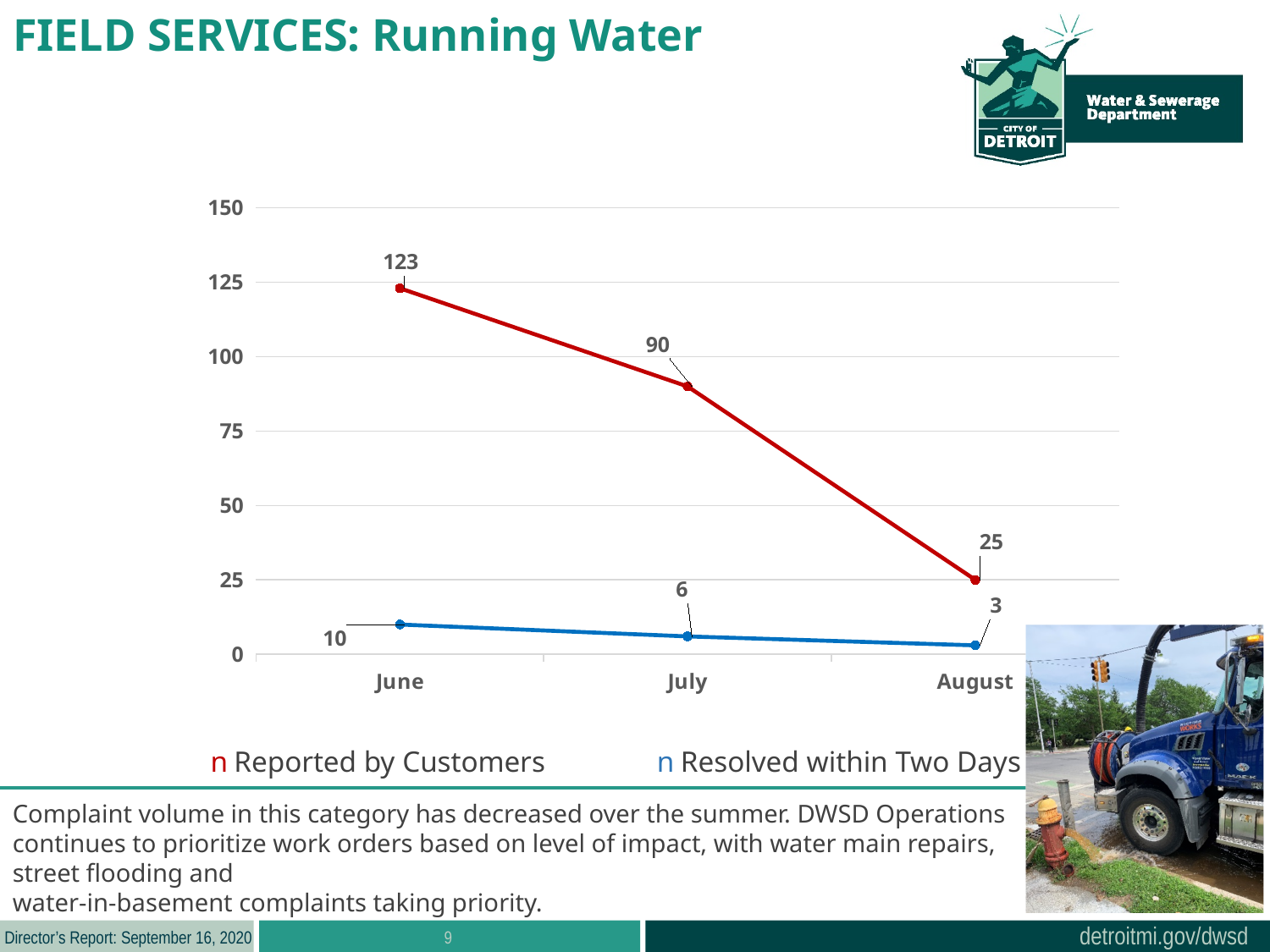
What colour is the line for Resolved within Two Days? blue What is the value for Reported by Customers in July? 90 In which month is Reported by Customers highest? June Does Reported by Customers rise or fall from June to August? fall What is the value for Reported by Customers in June? 123 Which is larger in July: Reported by Customers or Resolved within Two Days? Reported by Customers How many series does the legend list? 2 What type of chart is shown on the slide? line chart What is the value for Resolved within Two Days in August? 3 What is the difference between Reported by Customers in June and in August? 98 How many months are plotted on the x axis? 3 In which month is Resolved within Two Days lowest? August